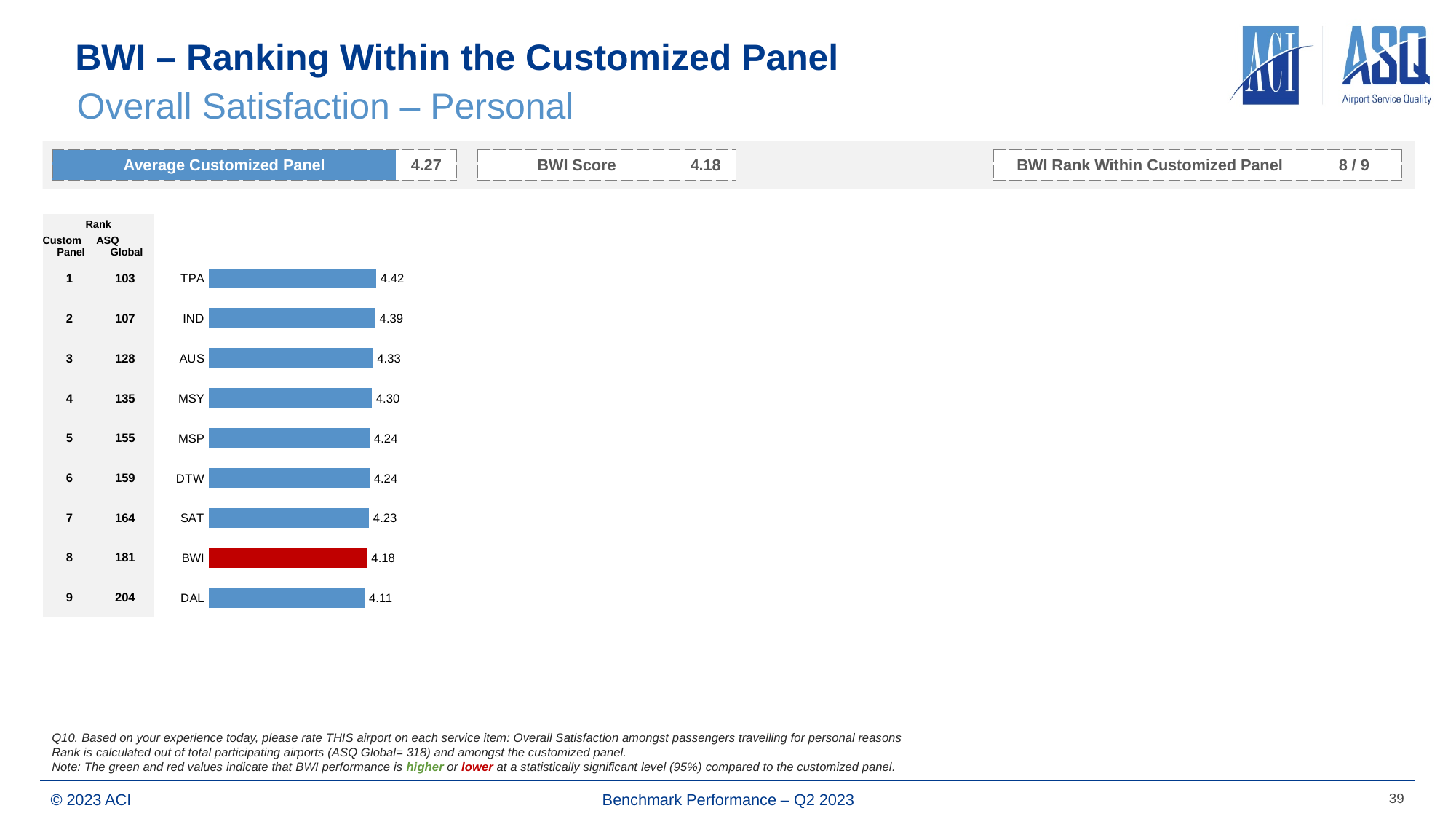
What is the value for BWI? 4.18 What is the value for TPA? 4.42 What is the difference between the values for IND and DAL? 0.28 What is the difference between the values for TPA and BWI? 0.24 Which is larger, the value for AUS or the value for SAT? AUS How many airports are shown in the chart? 9 Which airport has the highest value? TPA Which bar is coloured red? BWI Which airport has the lowest value? DAL What kind of chart is shown? bar chart What is the value for MSY? 4.30 What is the value for DAL? 4.11